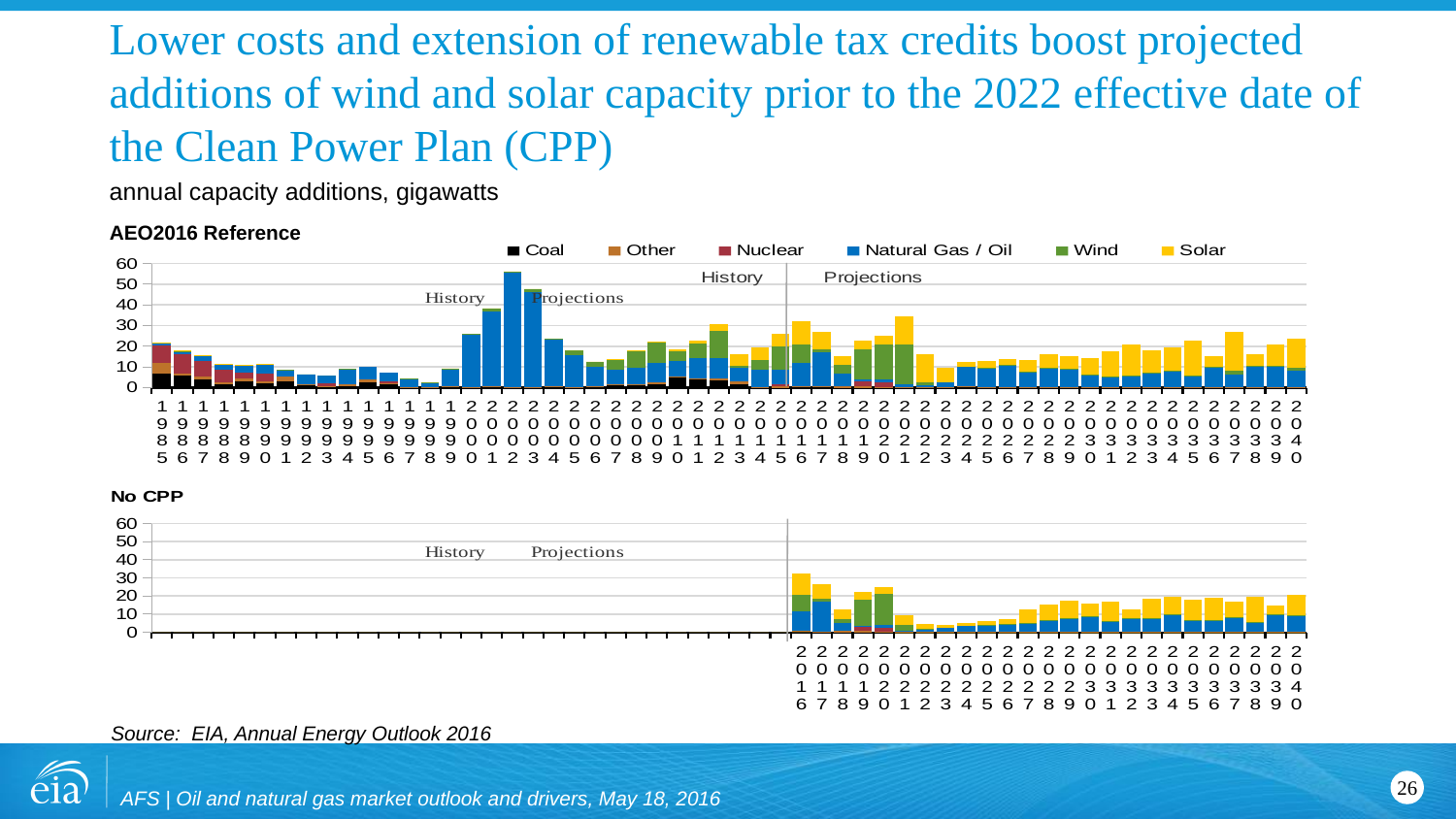
How many series does the legend of the AEO2016 Reference chart list? 6 In the AEO2016 Reference chart, is the total for 1998 greater or less than 10? less What kind of chart is the AEO2016 Reference chart? stacked bar chart In the No CPP chart, is the total for 2017 greater or less than 20? greater How many years are labeled on the x axis of the No CPP chart? 25 In the AEO2016 Reference chart, is the total for 2002 greater or less than 50? greater In the No CPP chart, do the totals rise or fall from 2016 to 2022? fall In the AEO2016 Reference chart, which year has the larger total, 2002 or 2003? 2002 In the AEO2016 Reference chart, which year has the tallest bar? 2002 Which series is shown in yellow in the legend? Solar